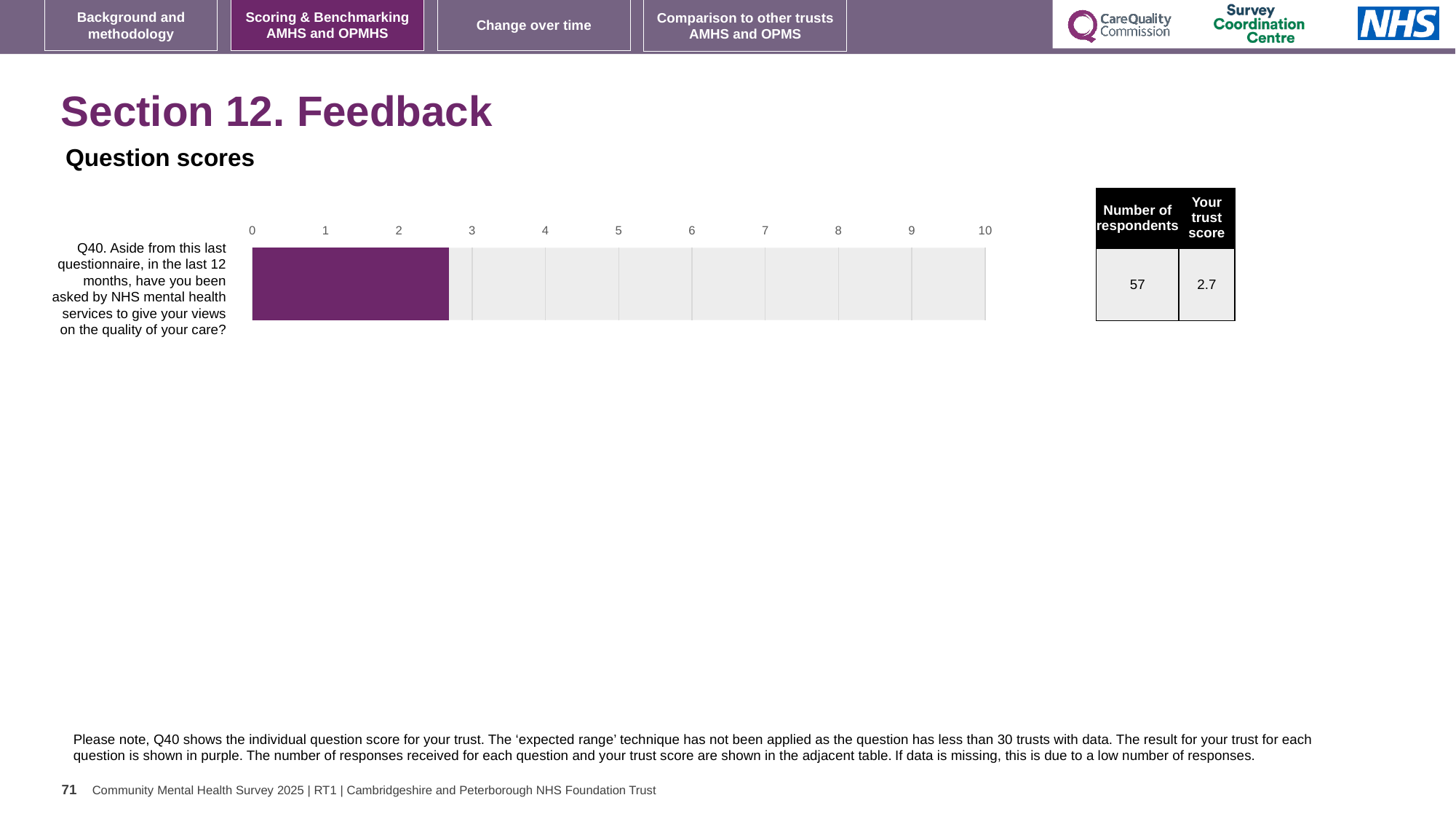
What kind of chart is shown on the slide? bar chart Is the bar for Q40 greater or less than 2 on the axis? greater What is the maximum value shown on the chart's horizontal axis? 10 What colour is the bar representing the trust's result for Q40? purple Which question number is plotted in the chart? Q40 What is the trust score for Q40 shown in the adjacent table? 2.7 Is the bar for Q40 greater or less than 3 on the axis? less How many respondents answered Q40 according to the table? 57 How many questions (categories) are plotted in the chart? 1